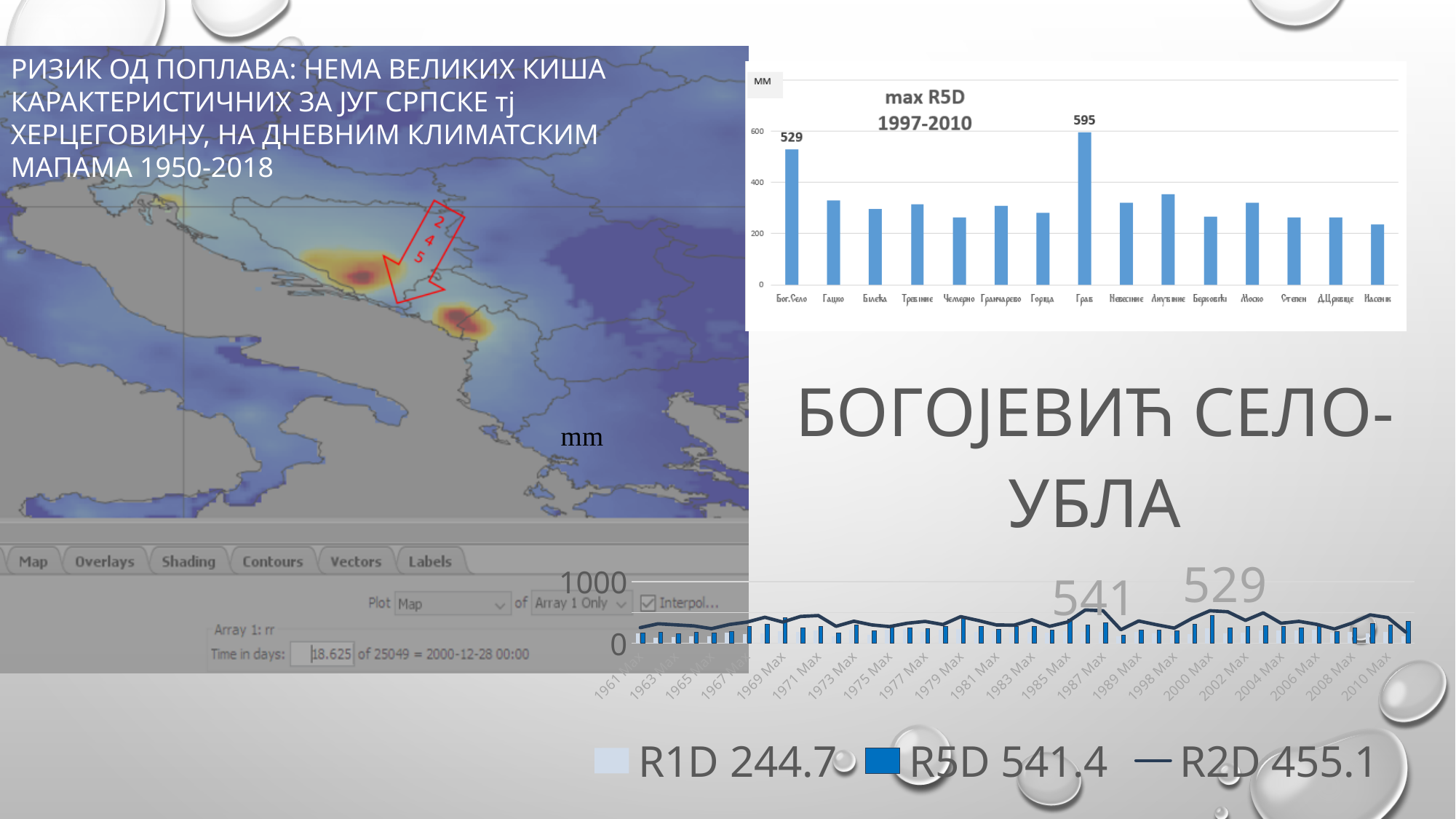
In the top-right chart 'max R5D 1997-2010', what is the difference between the values for Граб and Бог.Село? 66 In the top-right chart 'max R5D 1997-2010', which is larger, the value for Граб or for Бог.Село? Граб In the top-right chart 'max R5D 1997-2010', is the value for Гацко greater or less than 400? less In the top-right chart 'max R5D 1997-2010', what is the value for Граб? 595 How many series does the legend of the bottom chart 'БОГОЈЕВИЋ СЕЛО-УБЛА' list? 3 What are the legend entries of the bottom chart 'БОГОЈЕВИЋ СЕЛО-УБЛА'? R1D 244.7, R5D 541.4, R2D 455.1 In the top-right chart 'max R5D 1997-2010', what is the value for Бог.Село? 529 In the top-right chart 'max R5D 1997-2010', which station has the highest value? Граб In the bottom chart 'БОГОЈЕВИЋ СЕЛО-УБЛА', is the highest plotted value greater or less than 1000? less How many stations (bars) are shown in the top-right chart 'max R5D 1997-2010'? 15 In the top-right chart 'max R5D 1997-2010', is the value for Граб greater or less than 400? greater What kind of chart is the top-right chart 'max R5D 1997-2010'? bar chart